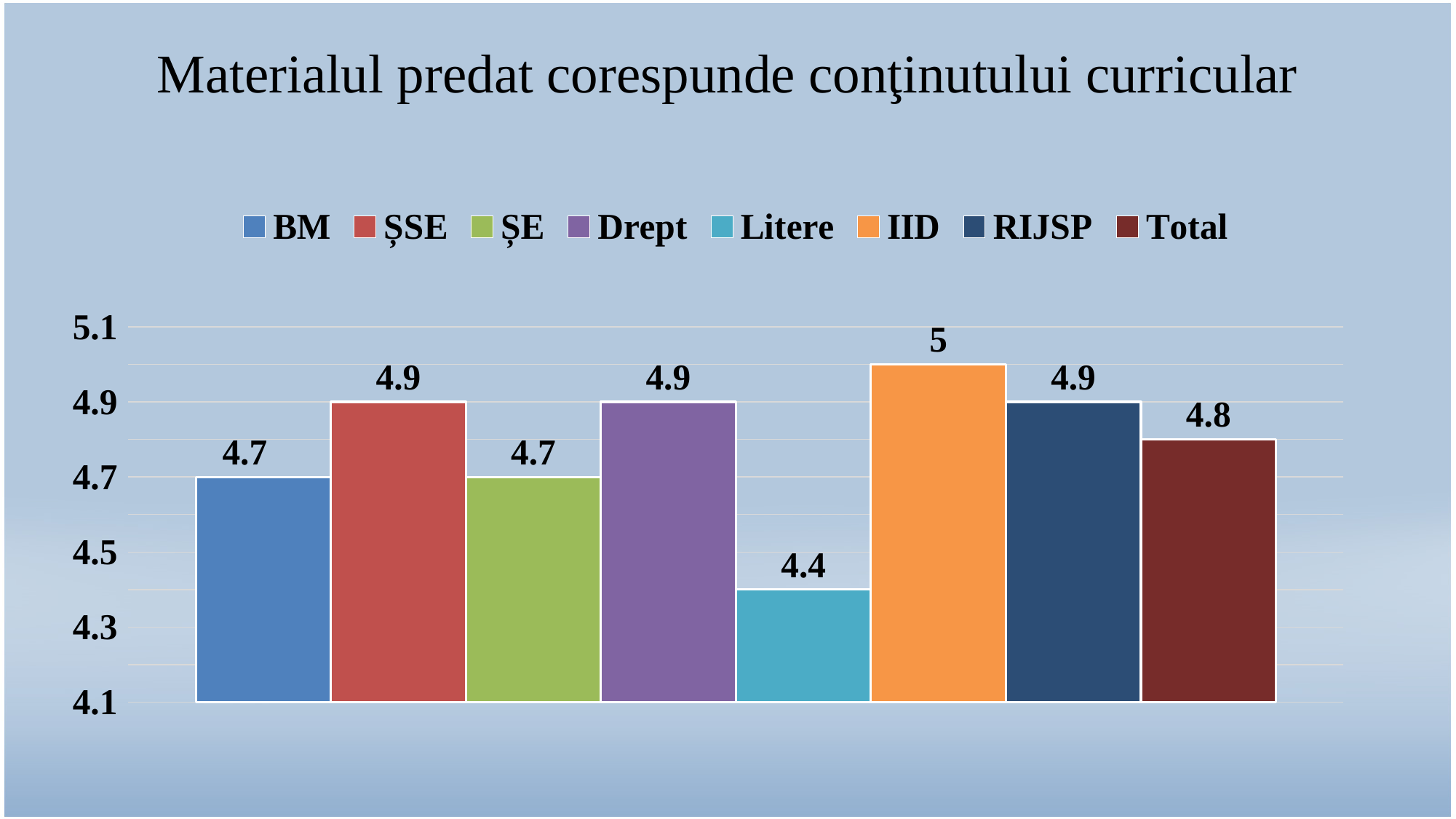
How many series does the legend list? 8 What is the value for BM? 4.7 What is the value for IID? 5 Which is larger, the value for Drept or the value for ȘE? Drept What is the difference between the values for IID and Litere? 0.6 What is the value for Total? 4.8 Which series has the lowest value? Litere What kind of chart is shown on the slide? Bar chart Which series has the highest value? IID What is the title of the chart? Materialul predat corespunde conţinutului curricular What is the difference between the values for ȘSE and BM? 0.2 What is the value for Litere? 4.4